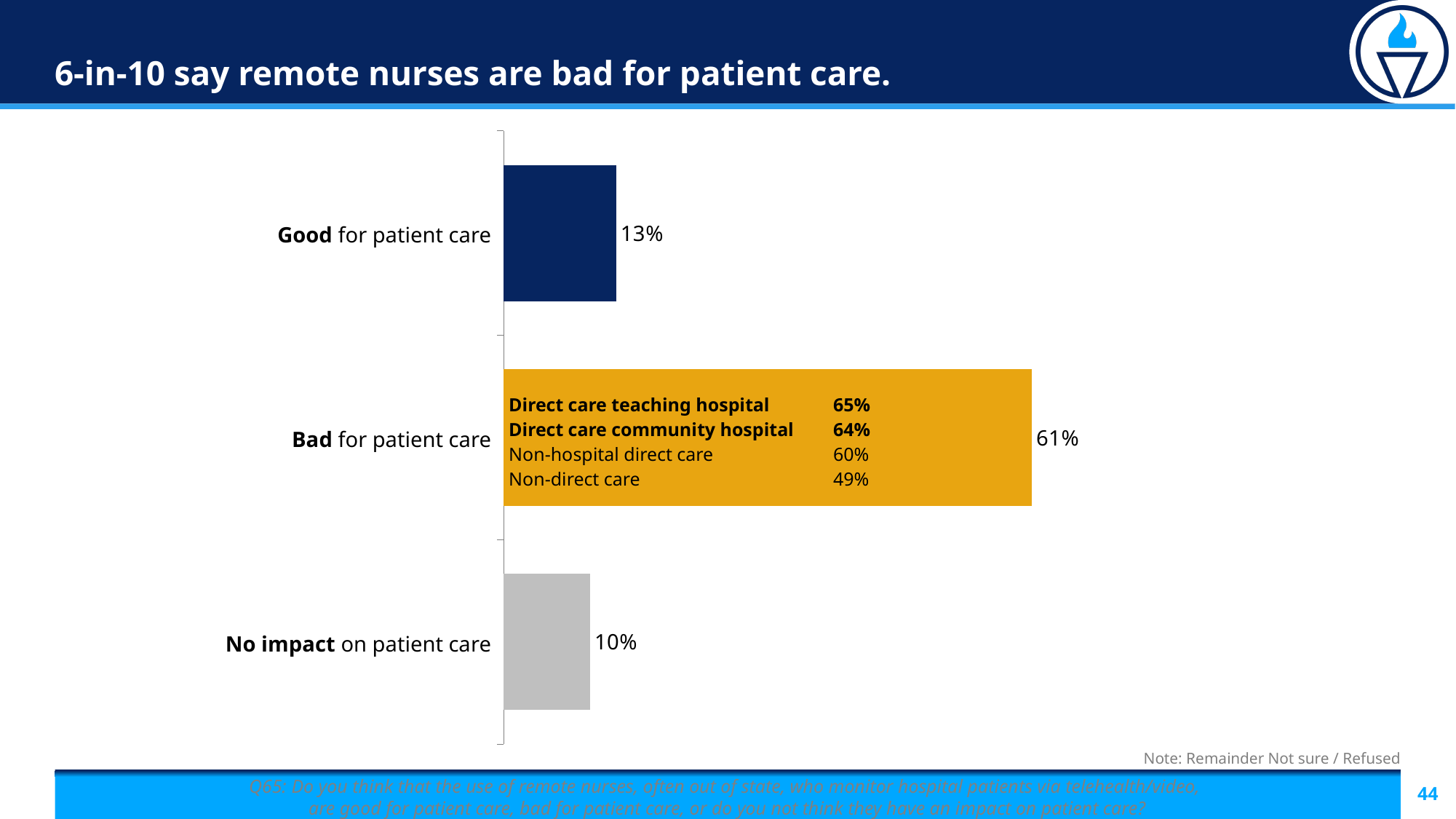
What percentage say remote nurses are bad for patient care? 61% What is the difference between the 'Bad for patient care' and 'Good for patient care' values? 48 percentage points How many response categories are shown in the chart? 3 What colour is the bar for 'Bad for patient care'? Orange/gold Within the 'Bad for patient care' bar, what percentage is shown for Direct care teaching hospital? 65% Within the 'Bad for patient care' bar, what percentage is shown for Non-direct care? 49% What percentage say remote nurses have no impact on patient care? 10% Which is larger, the value for 'Good for patient care' or 'No impact on patient care'? Good for patient care Which response category has the highest value? Bad for patient care What percentage say remote nurses are good for patient care? 13% Which response category has the lowest value? No impact on patient care What kind of chart is shown on the slide? Bar chart